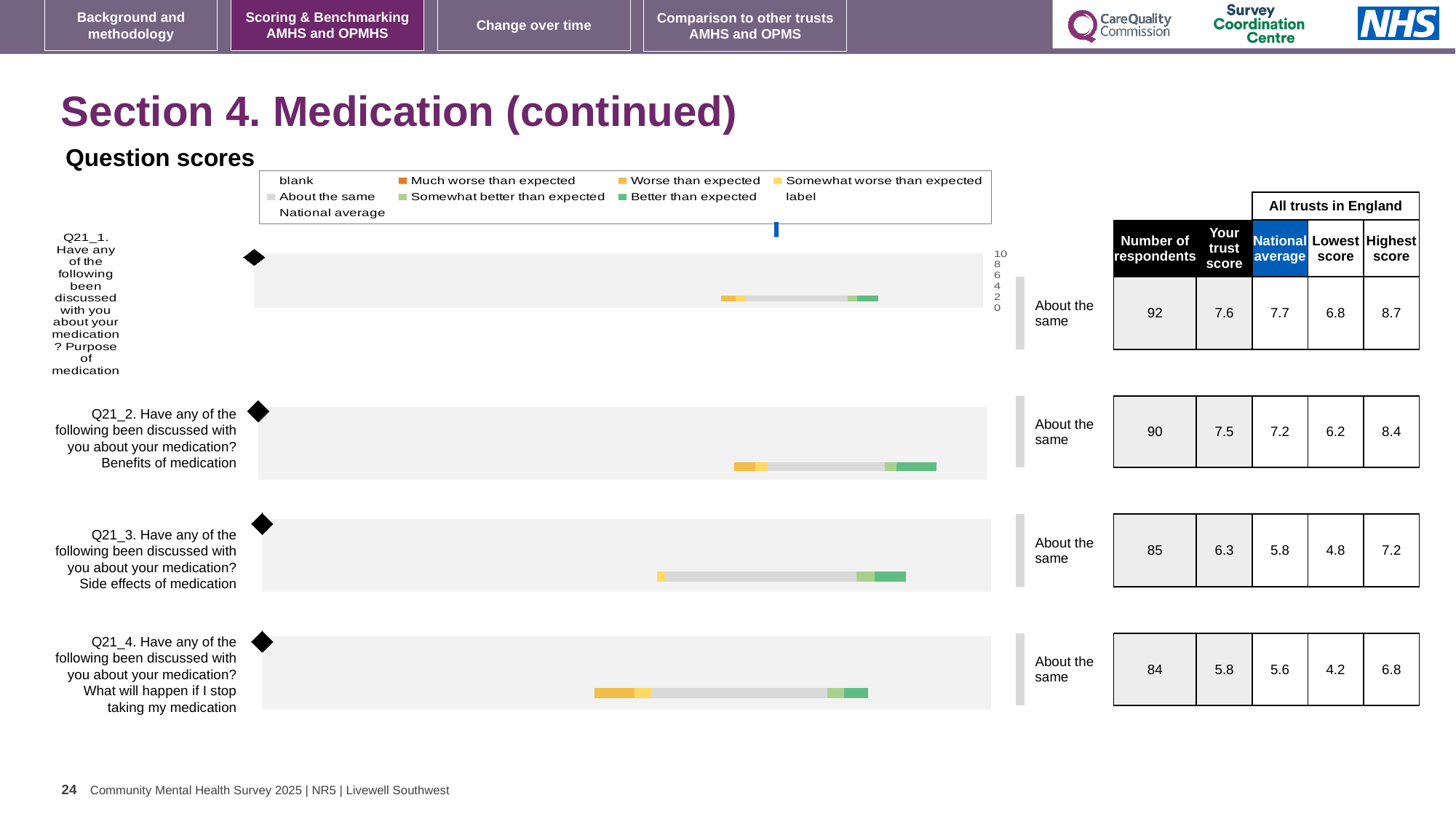
What benchmark category is shown for all four questions? About the same How many questions (Q21_1 to Q21_4) are plotted on the slide? 4 Which question has the lowest 'Your trust score'? Q21_4 (What will happen if I stop taking my medication) What is the difference between the highest score and the lowest score for Q21_4? 2.6 Which question has the highest 'Your trust score'? Q21_1 (Purpose of medication) What is the 'Your trust score' for Q21_2 (Benefits of medication)? 7.5 How many respondents answered Q21_1 (Purpose of medication)? 92 What kind of chart is used to show the question scores on this slide? bar chart What is the national average for Q21_3 (Side effects of medication)? 5.8 For Q21_3 (Side effects of medication), is the trust score higher or lower than the national average? higher What is the lowest score among all trusts in England for Q21_3 (Side effects of medication)? 4.8 What is the highest score among all trusts in England for Q21_2 (Benefits of medication)? 8.4